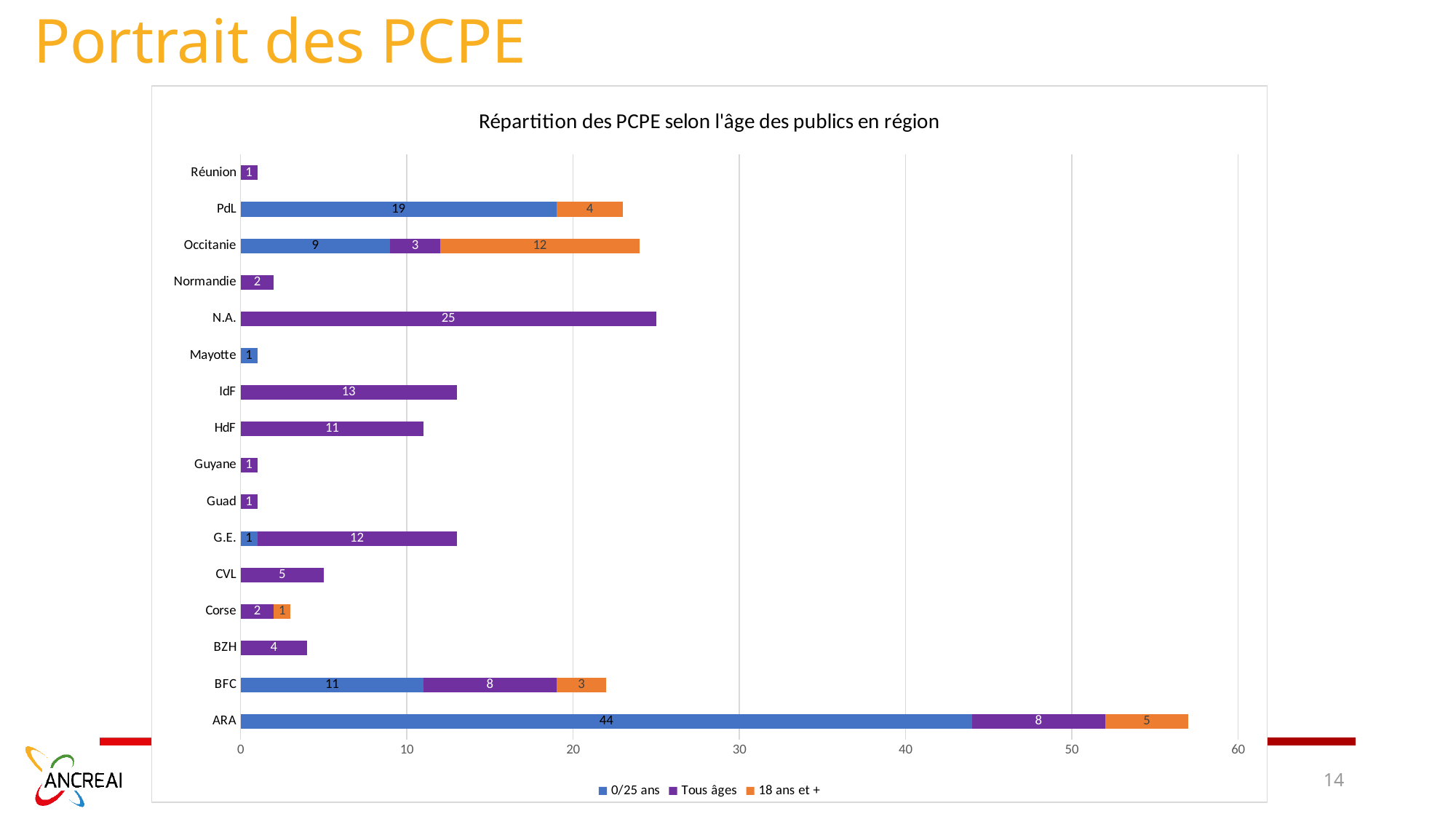
What is the value of the '18 ans et +' series for Occitanie? 12 What is the difference between the '0/25 ans' value for PdL and the '0/25 ans' value for Occitanie? 10 What kind of chart is shown on the slide? Stacked bar chart How many series does the legend list? 3 What is the total of the stacked bar for ARA? 57 How many regions (categories) are shown on the chart? 16 What is the title of the chart? Répartition des PCPE selon l'âge des publics en région Which is larger: the 'Tous âges' value for IdF or the 'Tous âges' value for HdF? IdF What is the value of the 'Tous âges' series for N.A.? 25 What is the value of the '0/25 ans' series for ARA? 44 Which region has the highest total number of PCPE? ARA What is the total of the stacked bar for BFC? 22